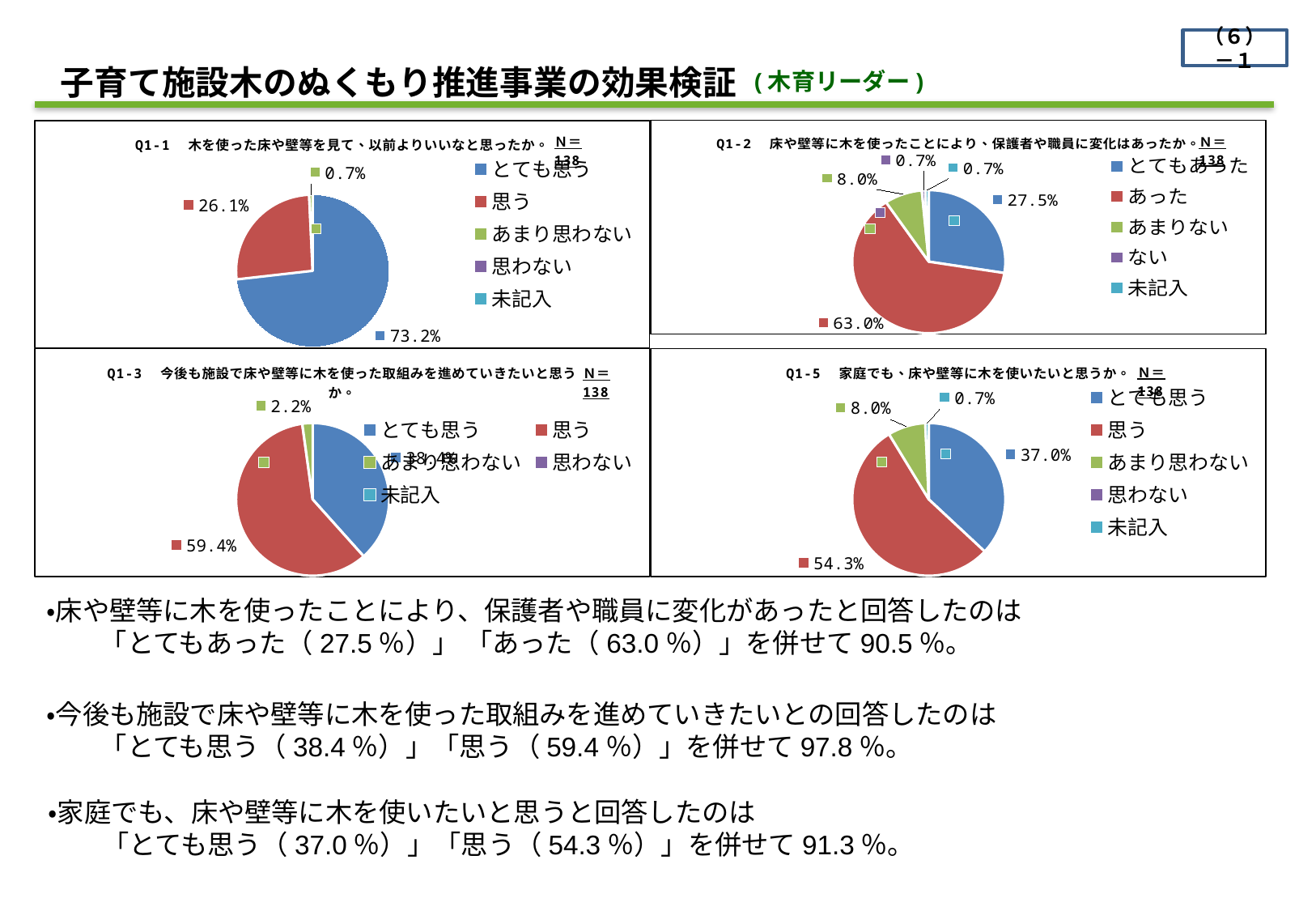
What type of chart is used for Q1-5 (bottom right)? Pie chart In the Q1-3 chart (bottom left), what percentage answered 「思う」? 59.4% How many entries does the legend of the Q1-2 chart (top right) list? 5 In the Q1-1 chart (top left), which is larger, the share for 「とても思う」 or the share for 「思う」? とても思う In the Q1-1 chart (top left), what percentage of respondents answered 「とても思う」? 73.2% In the Q1-5 chart (bottom right), what is the difference between the 「思う」 share and the 「とても思う」 share? 17.3% In the Q1-2 chart (top right), what percentage answered 「あった」? 63.0% In the Q1-3 chart (bottom left), what percentage answered 「あまり思わない」? 2.2% In the Q1-2 chart (top right), which response has the largest share? あった In the Q1-2 chart (top right), what percentage answered 「とてもあった」? 27.5% In the Q1-5 chart (bottom right), what percentage answered 「思う」? 54.3% In the Q1-1 chart (top left), what percentage answered 「思う」? 26.1%